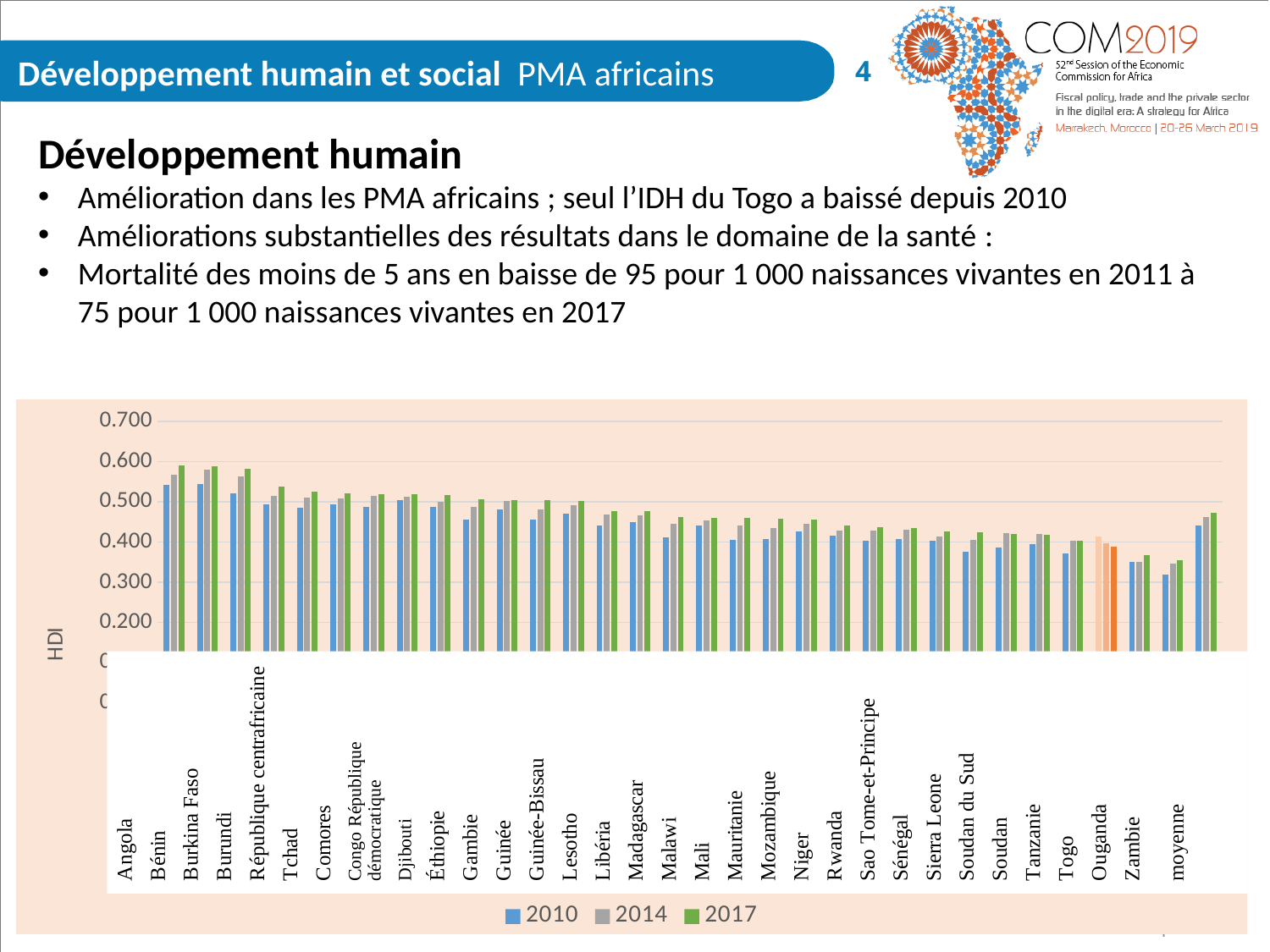
Is the 2017 value for moyenne greater or less than 0.500? less For Togo, the group highlighted in orange, do the values rise or fall from 2010 to 2017? fall What is the label on the vertical axis of the chart? HDI What is the highest tick value shown on the vertical axis of the HDI chart? 0.700 How many series does the legend of the HDI chart list? 3 Which years are listed in the legend of the HDI chart? 2010, 2014, 2017 Is the 2010 value for the first country group on the left greater or less than 0.500? greater How many categories (countries plus the average) are shown on the x axis of the HDI chart? 32 What kind of chart is shown on the slide? bar chart For Togo, the group highlighted in orange, which is larger: the 2010 value or the 2017 value? 2010 Is the 2017 value for moyenne greater or less than 0.400? greater